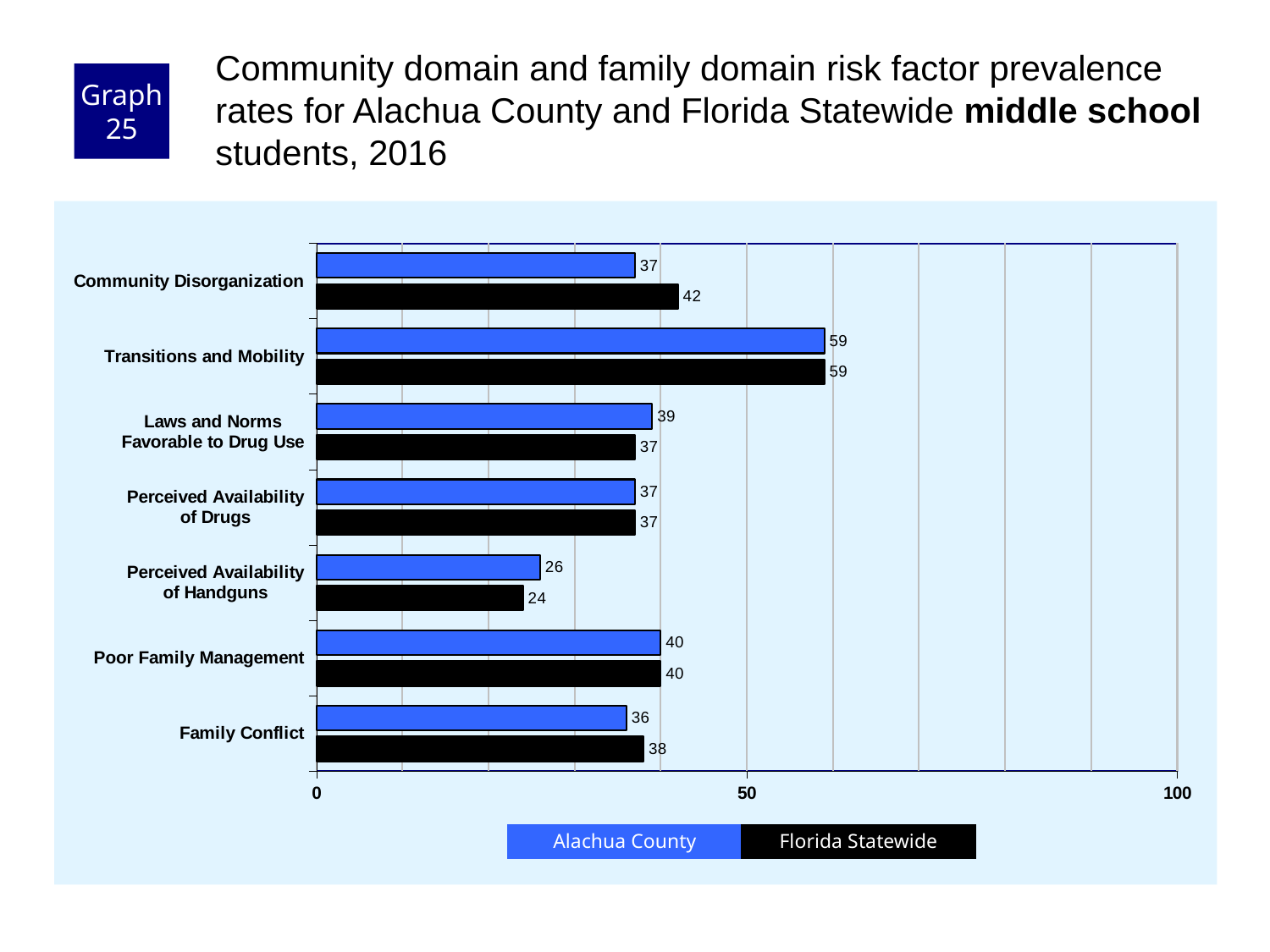
Which colour represents Florida Statewide in the chart? black How many risk factor categories are shown on the chart? 7 What is the difference between the Florida Statewide and Alachua County values for Community Disorganization? 5 How many series does the legend list? 2 Which risk factor has the lowest Florida Statewide value? Perceived Availability of Handguns Which is larger for Family Conflict: the Alachua County value or the Florida Statewide value? Florida Statewide Is the Alachua County value for Transitions and Mobility greater or less than 50? greater What kind of chart is shown on the slide? bar chart What is the Alachua County value for Community Disorganization? 37 What is the Alachua County value for Poor Family Management? 40 Which risk factor has the highest Alachua County value? Transitions and Mobility What is the Florida Statewide value for Perceived Availability of Handguns? 24